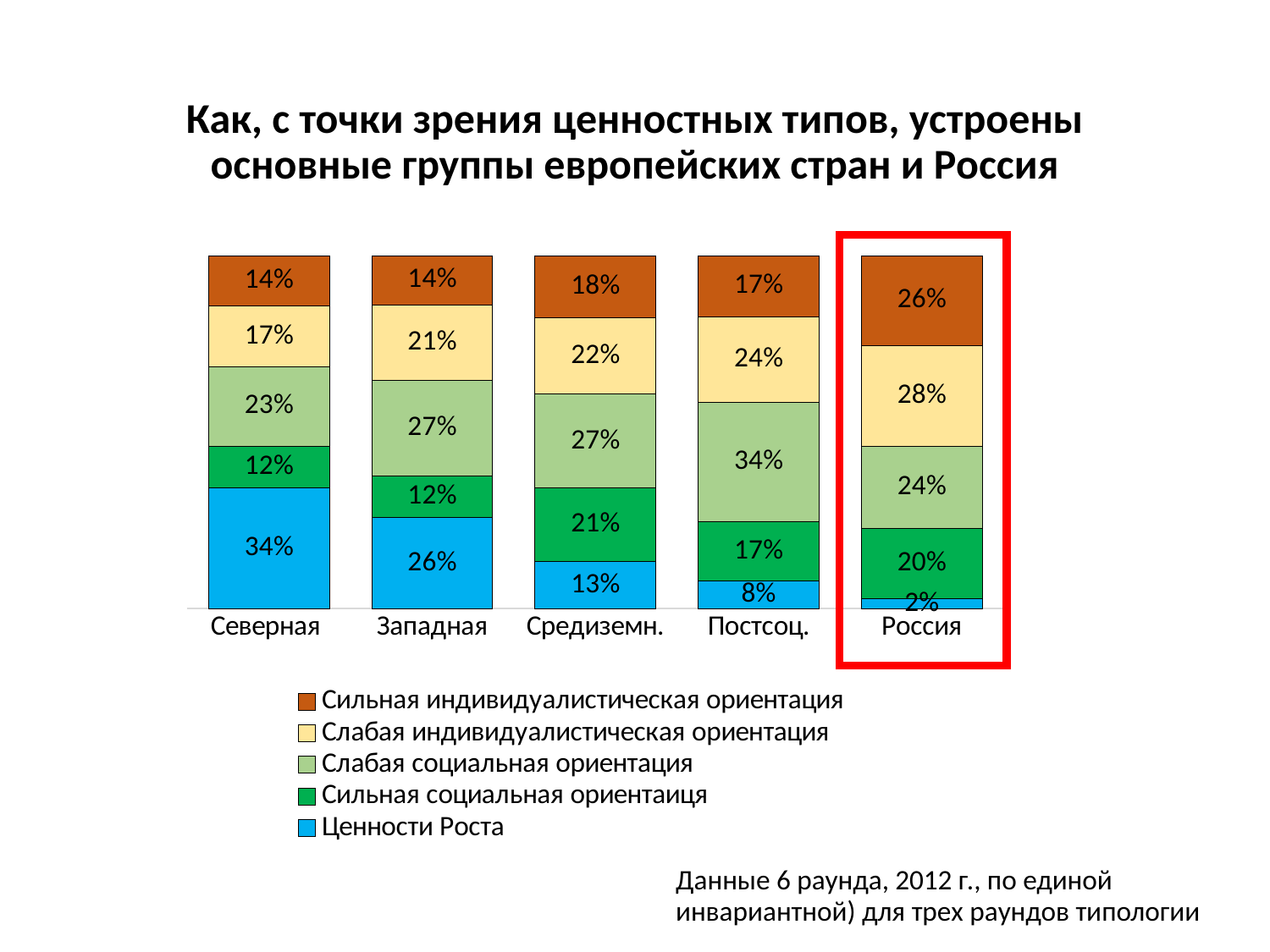
What is the value of "Сильная социальная ориентаиця" for Средиземн.? 21% What is the difference between the "Слабая индивидуалистическая ориентация" values for Россия and Северная? 11% What is the value of "Сильная индивидуалистическая ориентация" for Россия? 26% What is the value of "Слабая социальная ориентация" for Постсоц.? 34% Which category has the lowest value for "Ценности Роста"? Россия What kind of chart is shown on the slide? Stacked bar chart Which category is highlighted with a red box on the chart? Россия How many series does the legend list? 5 How many categories are shown on the x axis? 5 Which category has the highest value for "Ценности Роста"? Северная Which is larger: the "Сильная социальная ориентаиця" value for Россия or for Западная? Россия What is the value of "Ценности Роста" for Северная? 34%